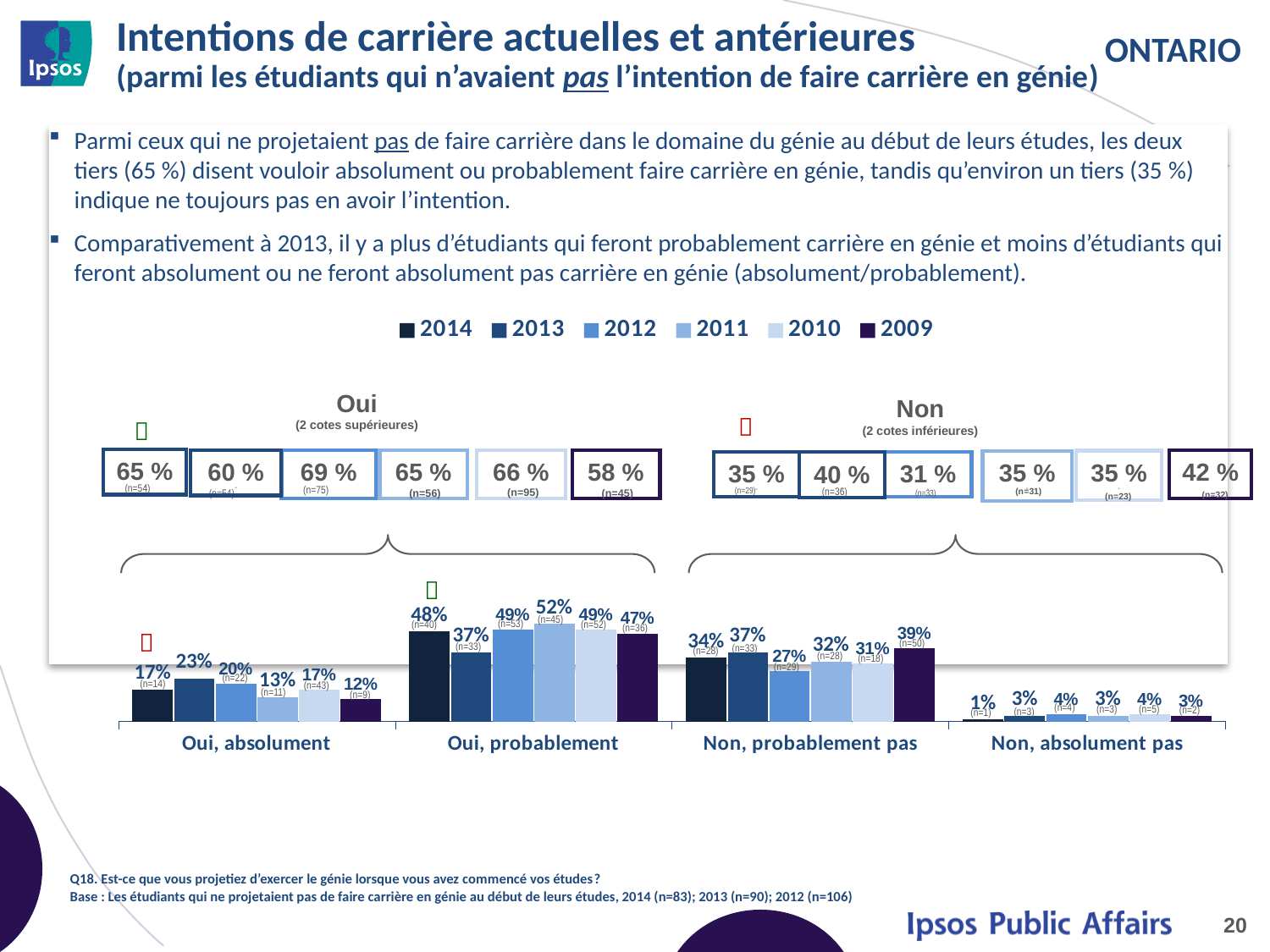
What is the 2014 value for "Non, absolument pas"? 1% Which year has the lowest value for "Oui, absolument"? 2009 Which is larger for "Non, probablement pas": the 2013 value or the 2012 value? 2013 How many categories are shown along the x axis of the chart? 4 What is the 2013 value for "Oui, absolument"? 23% What is the 2009 value for "Non, probablement pas"? 39% Which year has the highest value for "Oui, probablement"? 2011 What is the 2014 value shown in the "Oui (2 cotes supérieures)" summary box? 65 % How many series does the legend list? 6 What is the 2014 value for "Oui, probablement"? 48% What is the difference between the 2014 and 2013 values for "Oui, probablement"? 11% What kind of chart is shown on the slide? bar chart